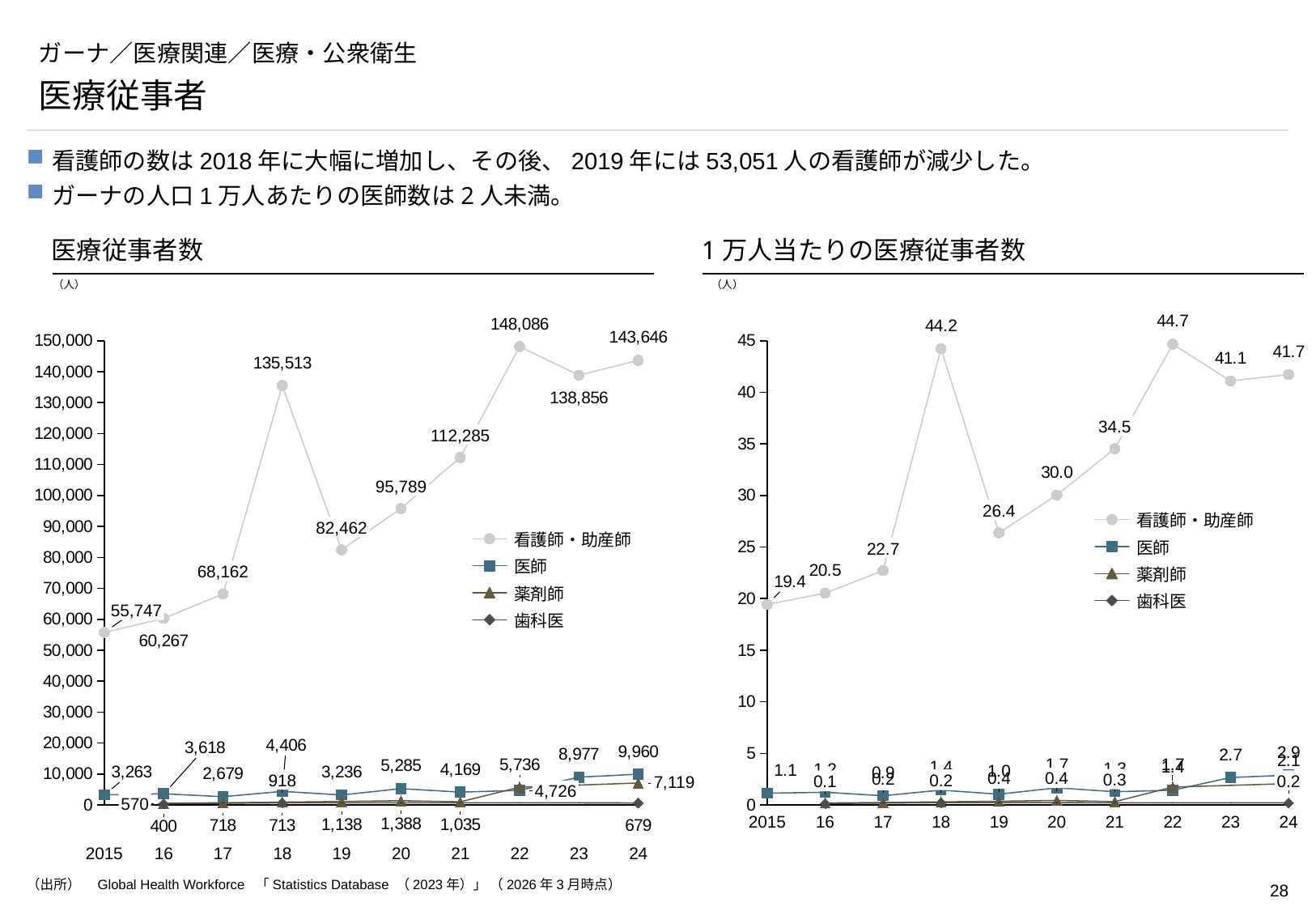
In the 医療従事者数 chart on the left, what is the difference between the 看護師・助産師 values for 2022 and 2023? 9,230 In the 医療従事者数 chart on the left, what is the value for 医師 in 2024? 9,960 In the 医療従事者数 chart on the left, what is the value for 看護師・助産師 in 2018? 135,513 In the 医療従事者数 chart on the left, what is the difference between the 医師 values for 2024 and 2023? 983 How many series does the legend of the 医療従事者数 chart on the left list? 4 In the 1万人当たりの医療従事者数 chart on the right, what is the value for 医師 in 2023? 2.7 In the 医療従事者数 chart on the left, in which year is the 看護師・助産師 value highest? 22 (2022) In the 1万人当たりの医療従事者数 chart on the right, in which year is the 看護師・助産師 value lowest? 2015 In the 1万人当たりの医療従事者数 chart on the right, what is the value for 看護師・助産師 in 2022? 44.7 In the 医療従事者数 chart on the left, in which year is the 看護師・助産師 value lowest? 2015 What kind of chart is the 1万人当たりの医療従事者数 chart on the right? Line chart How many years are plotted along the x axis of the 医療従事者数 chart on the left? 10